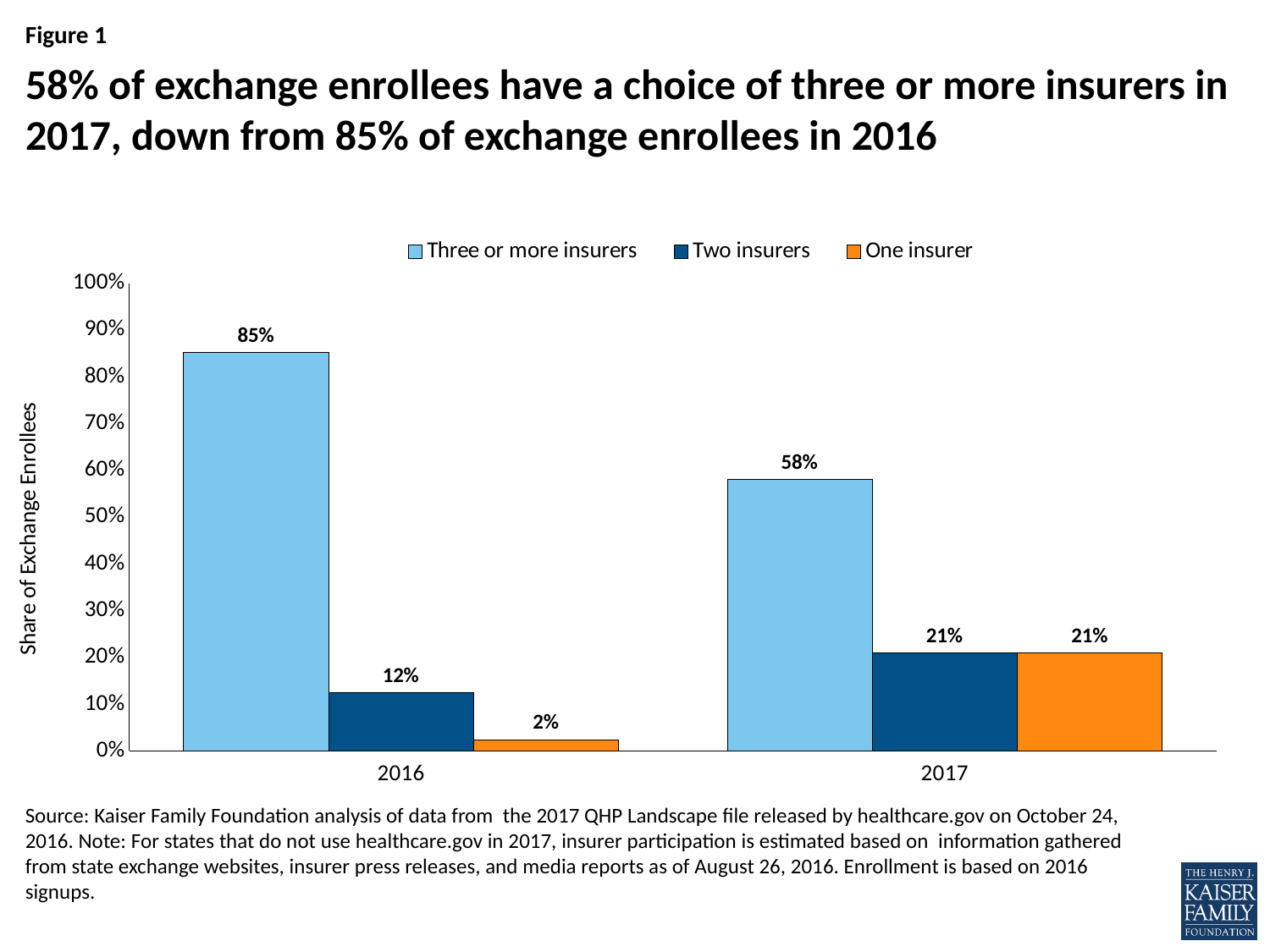
By how many percentage points did the share of enrollees with three or more insurers fall from 2016 to 2017? 27 percentage points What share of exchange enrollees had a choice of three or more insurers in 2016? 85% What is the difference between the one-insurer share in 2017 and in 2016? 19 percentage points How many series does the legend list? 3 What share of exchange enrollees had a choice of two insurers in 2016? 12% What kind of chart is shown? Bar chart What share of exchange enrollees have a choice of only one insurer in 2017? 21% Which series has the lowest value in 2016? One insurer What is the label on the vertical axis? Share of Exchange Enrollees Which is larger: the two-insurers share in 2016 or the two-insurers share in 2017? 2017 How many year categories are shown on the x axis? 2 Which series has the highest value in 2017? Three or more insurers